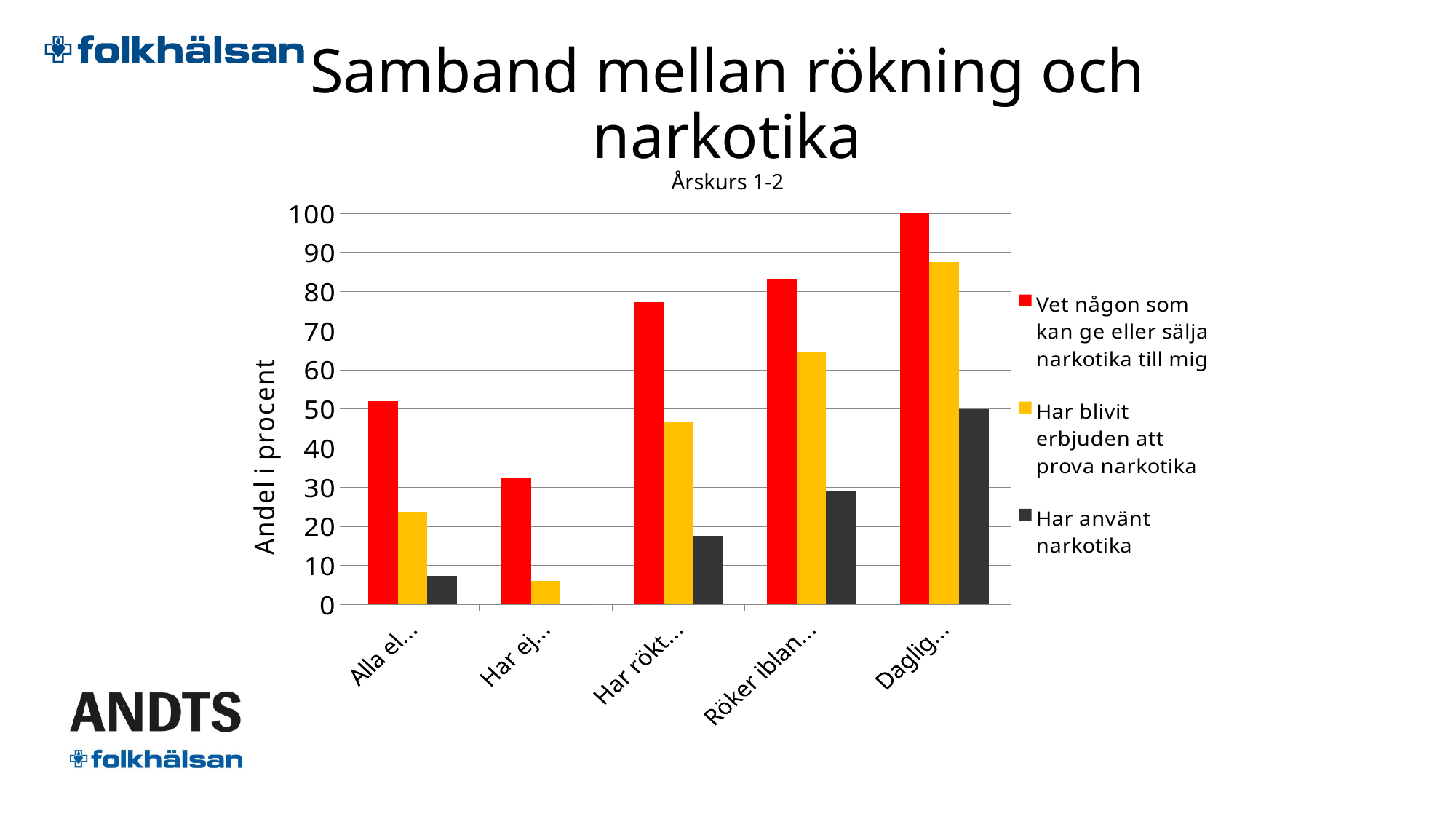
How many series does the legend list? 3 Which category has the highest value for 'Vet någon som kan ge eller sälja narkotika till mig'? Daglig... How many categories are shown on the x axis? 5 Which category has the lowest value for 'Har blivit erbjuden att prova narkotika'? Har ej... Is the value for 'Vet någon som kan ge eller sälja narkotika till mig' in the 'Har ej...' category greater or less than 40? less What is the value for 'Vet någon som kan ge eller sälja narkotika till mig' in the 'Daglig...' category? 100 In the 'Har rökt...' category, which is larger: 'Vet någon som kan ge eller sälja narkotika till mig' or 'Har blivit erbjuden att prova narkotika'? Vet någon som kan ge eller sälja narkotika till mig Is the value for 'Har använt narkotika' in the 'Har rökt...' category greater or less than 20? less What kind of chart is shown on the slide? bar chart What is the title of the y axis? Andel i procent Is the value for 'Har blivit erbjuden att prova narkotika' in the 'Röker iblan...' category greater or less than 60? greater Do the values for 'Har använt narkotika' rise or fall from 'Har ej...' to 'Daglig...'? rise